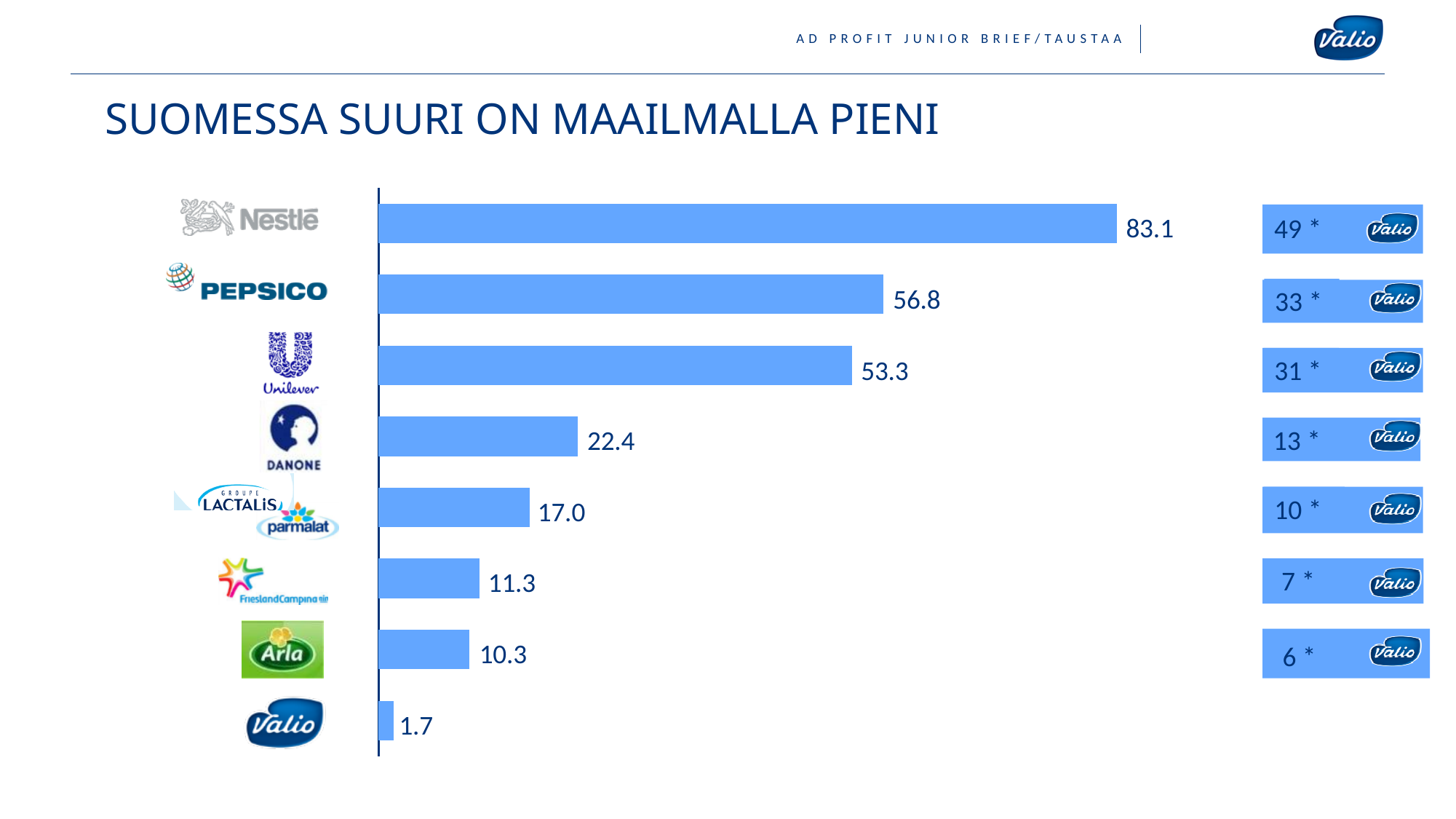
What is the value shown for Nestlé? 83.1 What is the value shown for Danone? 22.4 How many bars are shown in the chart? 8 What is the value shown for Arla? 10.3 Which company has the highest value in the chart? Nestlé What is the difference between the values for PepsiCo and Unilever? 3.5 What is the difference between the values for Nestlé and Valio? 81.4 Which has a larger value, Danone or FrieslandCampina? Danone Which company has the lowest value in the chart? Valio What is the value shown for PepsiCo? 56.8 What type of chart is shown on the slide? Bar chart What is the value shown for Valio? 1.7